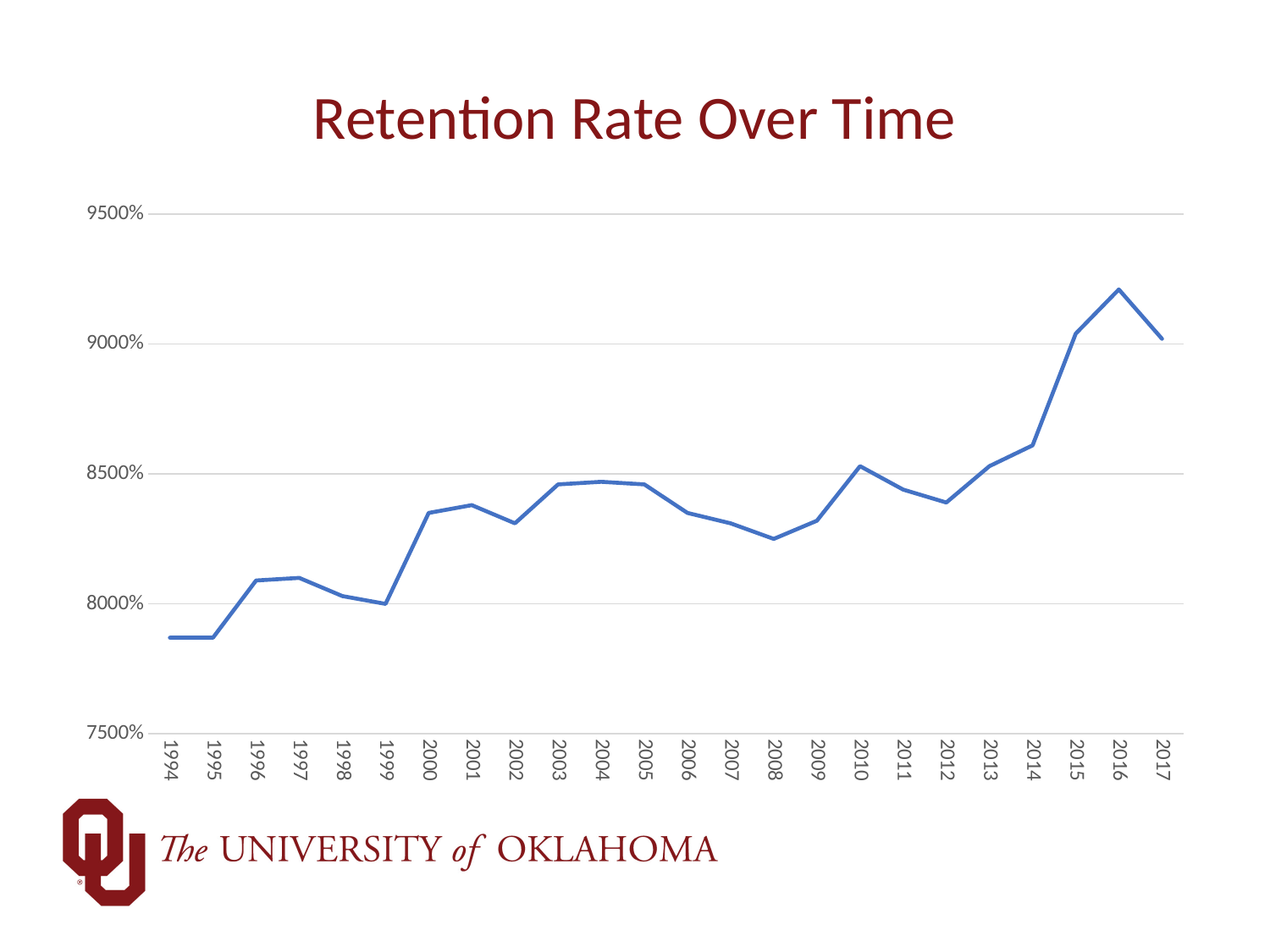
What kind of chart is shown on the slide? line chart How many years are plotted on the x axis of the chart? 24 Which year has the larger value, 1999 or 2000? 2000 Which year has the larger value, 2010 or 2012? 2010 Is the value for 1994 greater or less than 8000%? less Is the value for 2014 greater or less than 8500%? greater What is the title of the chart? Retention Rate Over Time Is the value for 2016 greater or less than 9000%? greater Does the retention rate rise or fall from 2016 to 2017? fall Which year has the highest retention rate on the chart? 2016